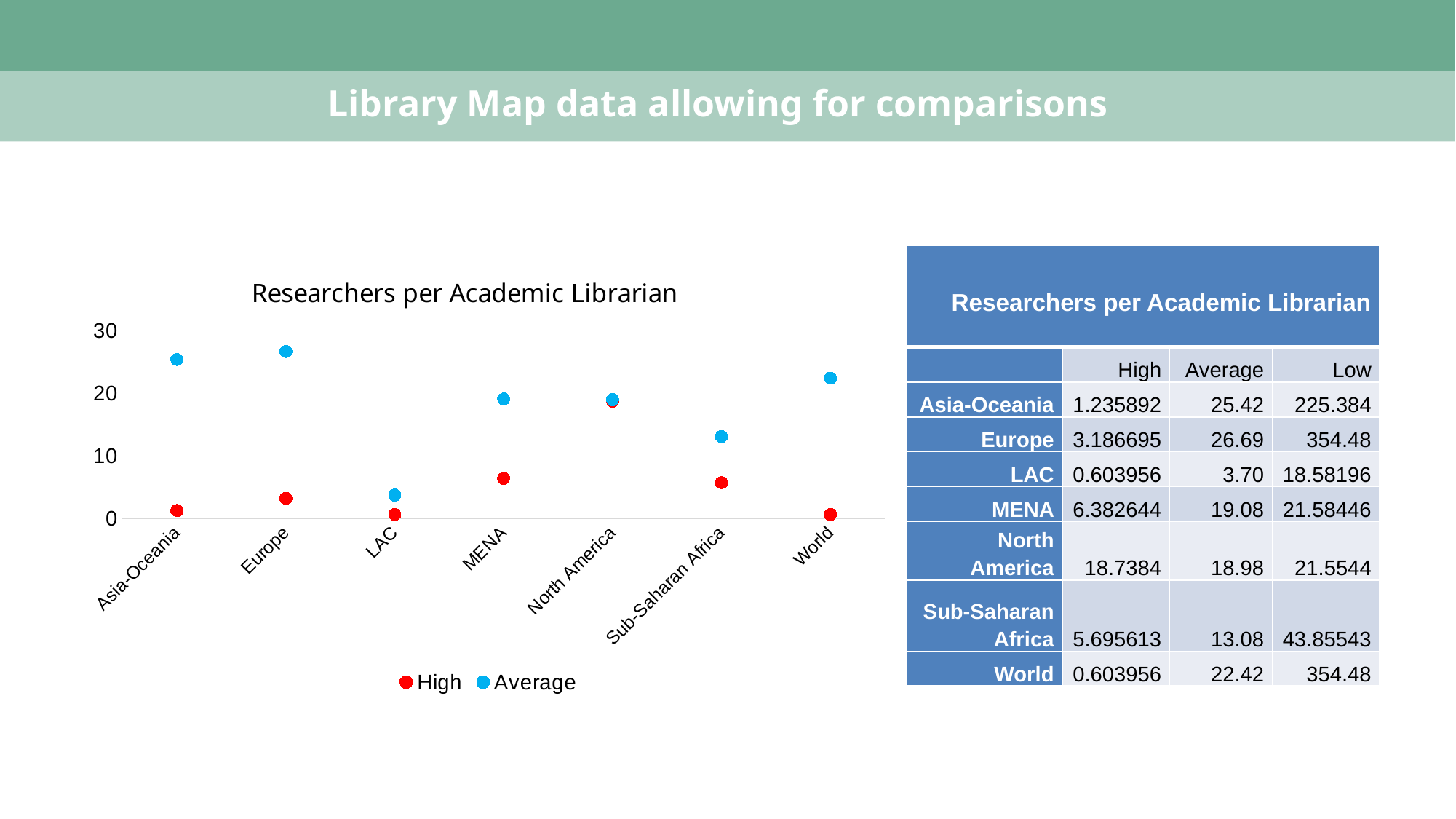
What is the title of the chart? Researchers per Academic Librarian Which region has the highest Average value in the chart? Europe Which colour marks the High series in the chart? red Which region has the lowest Average value in the chart? LAC Which is larger, the Average value for Europe or the Average value for Sub-Saharan Africa? Europe Which region has the highest High value in the chart? North America According to the table, what is the Average value of Researchers per Academic Librarian for World? 22.42 How many series does the chart legend list? 2 Is the Average value for Asia-Oceania greater or less than 20? greater Is the High value for MENA greater or less than 10? less What kind of chart is shown on the slide? scatter chart How many regions are plotted along the x axis of the chart? 7